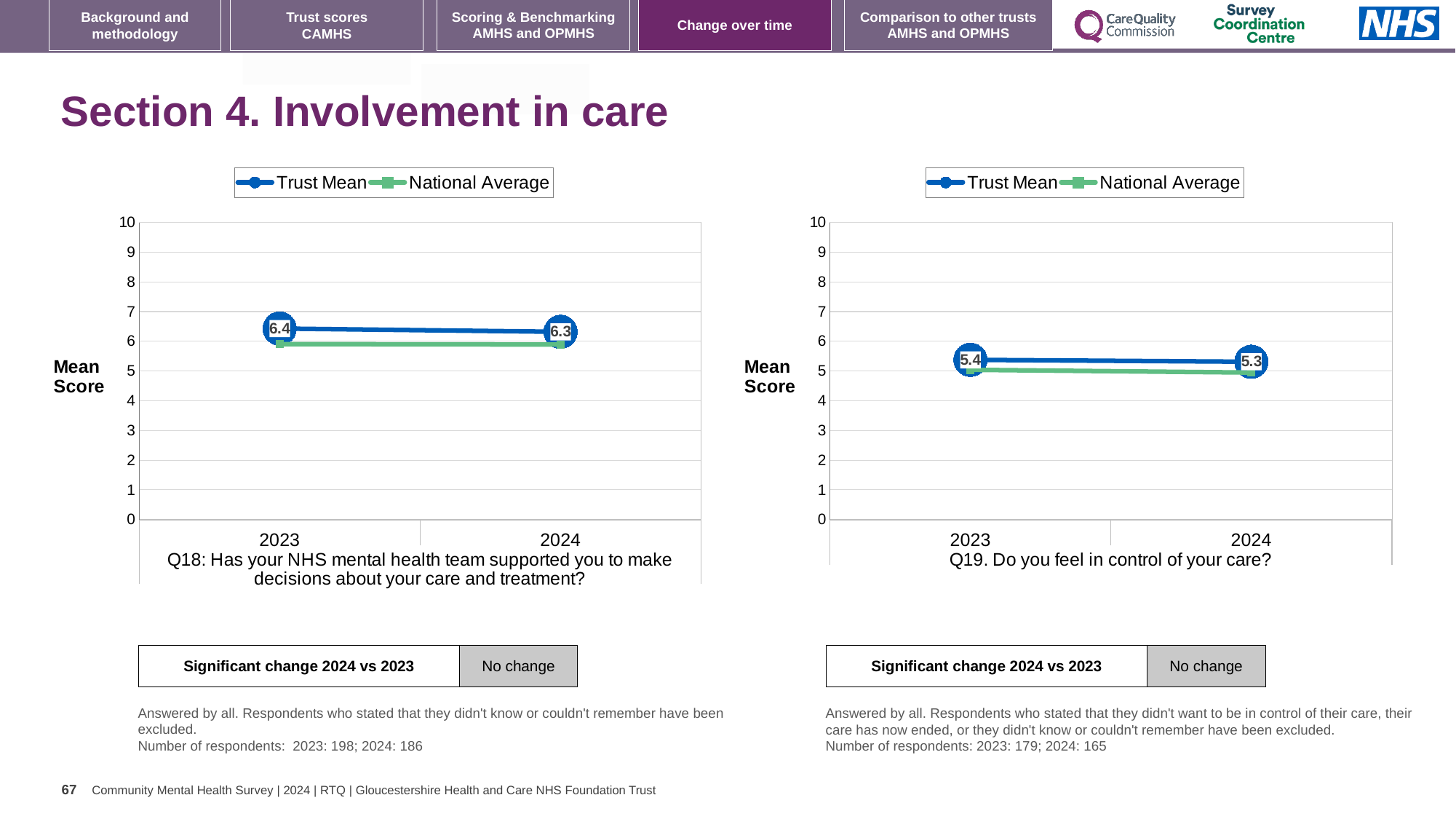
In the Q19 chart on the right, what is the Trust Mean score for 2023? 5.4 What is the y-axis label on the Q19 chart on the right? Mean Score In the Q18 chart on the left, by how much did the Trust Mean change from 2023 to 2024? 0.1 How many years are shown on the x axis of the Q18 chart on the left? 2 In the Q18 chart on the left, what is the Trust Mean score for 2024? 6.3 How many series does the legend of the Q19 chart on the right list? 2 What kind of chart is the Q18 chart on the left? line chart In the Q18 chart on the left, is the Trust Mean for 2023 greater or less than 6? greater In the Q18 chart on the left, what is the Trust Mean score for 2023? 6.4 In the Q19 chart on the right, which series is higher in 2023, Trust Mean or National Average? Trust Mean In the Q19 chart on the right, what is the Trust Mean score for 2024? 5.3 In the Q19 chart on the right, does the Trust Mean rise or fall from 2023 to 2024? fall